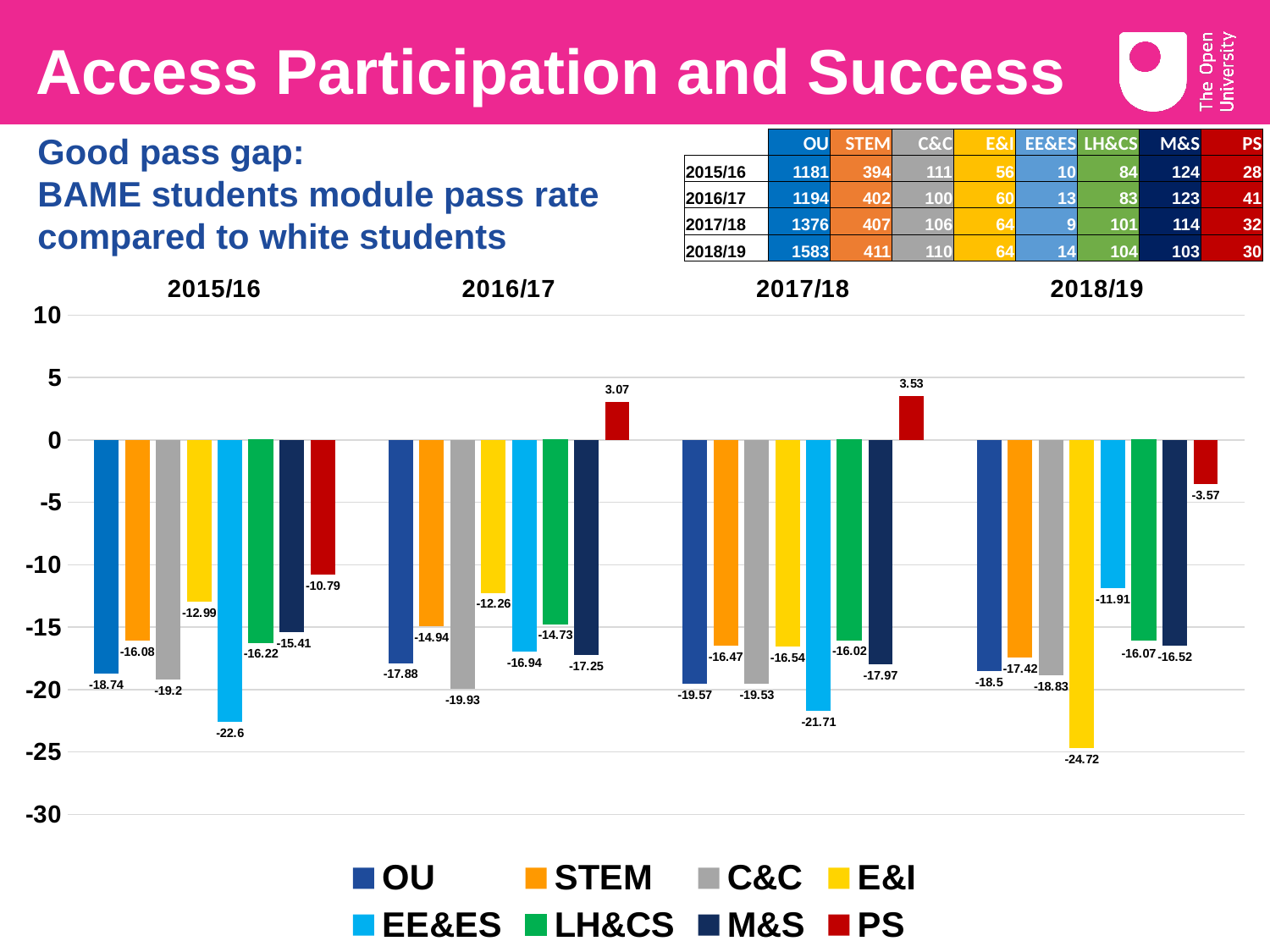
How many series does the legend list? 8 What is the value for OU in 2016/17? -17.88 What is the value for PS in 2017/18? 3.53 What kind of chart is shown on the slide? Bar chart Which is larger, the value for STEM in 2015/16 or the value for STEM in 2018/19? STEM in 2015/16 What is the difference between the PS values in 2017/18 and 2018/19? 7.1 What is the value for EE&ES in 2015/16? -22.6 What is the value for E&I in 2018/19? -24.72 Which series has the lowest value in 2018/19? E&I Which series has the highest value in 2016/17? PS Does the value for EE&ES rise or fall from 2017/18 to 2018/19? Rise How many year groups are shown on the x axis? 4